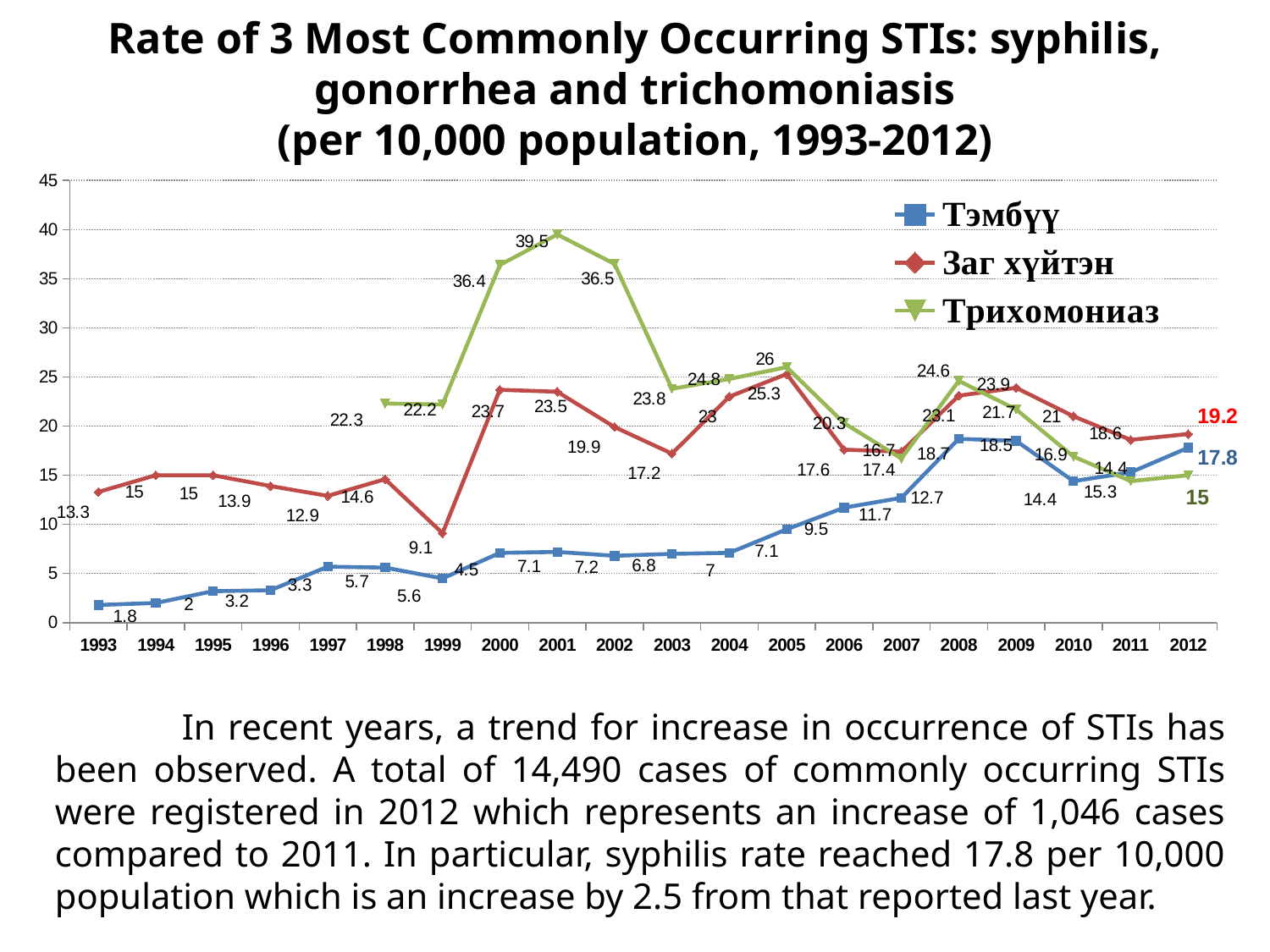
What is the value for Трихомониаз in 2012? 15 What kind of chart is shown on the slide? line chart What is the value for Тэмбүү in 2012? 17.8 Is the value for Трихомониаз in 2001 greater or less than 35? greater How many series does the legend list? 3 What is the difference between the Заг хүйтэн and Трихомониаз values in 2012? 4.2 How many years are shown on the x axis? 20 In which year is the Тэмбүү series at its lowest value? 1993 In 2012, which series has the larger value, Заг хүйтэн or Тэмбүү? Заг хүйтэн What is the value for Заг хүйтэн in 2012? 19.2 What is the value for Трихомониаз in 2001? 39.5 In which year does the Трихомониаз series reach its highest value? 2001